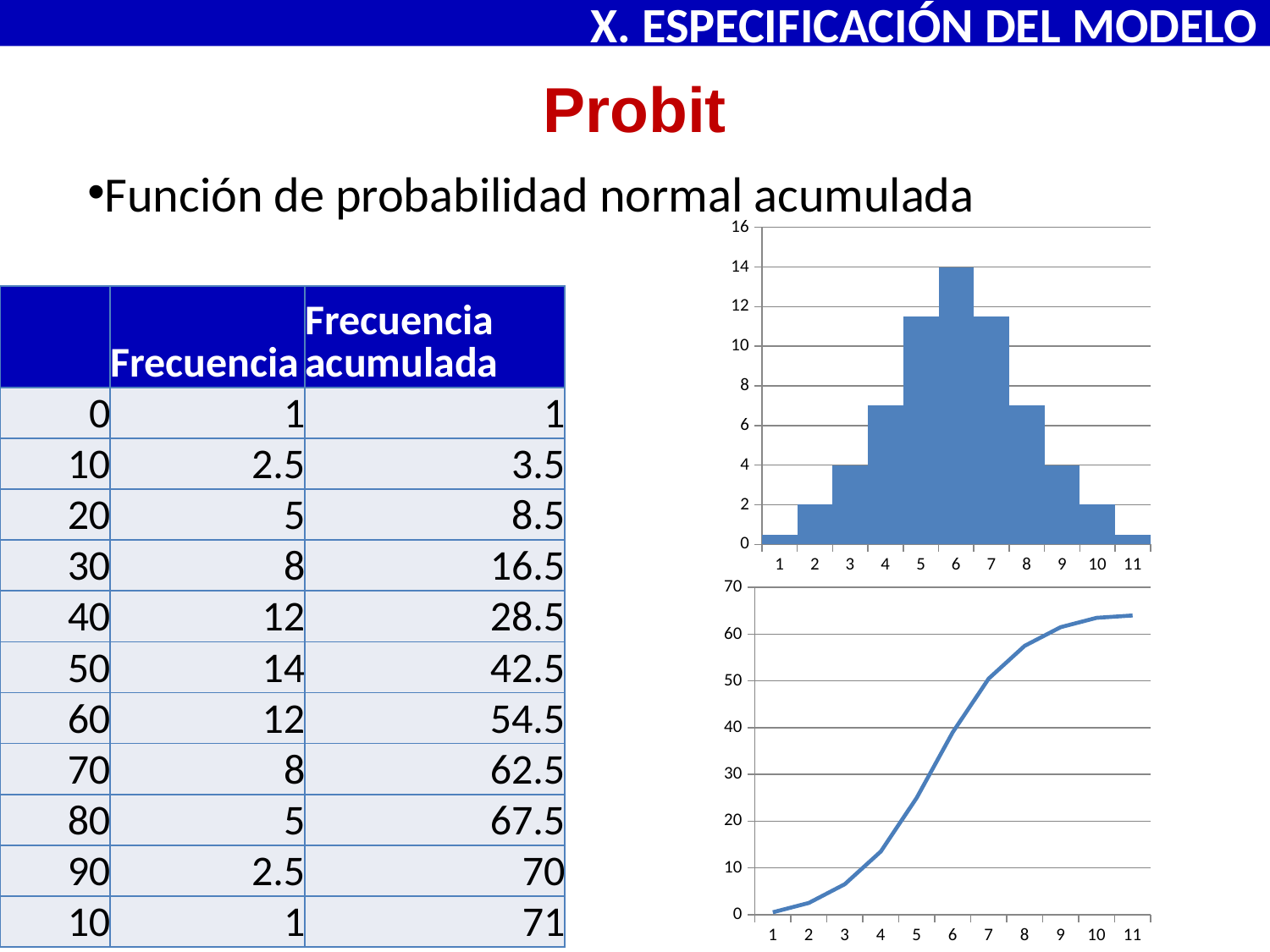
In the bottom line chart, is the value at point 1 greater or less than 10? less In the top bar chart, is the value for category 5 greater or less than 10? greater In the top bar chart, which is larger, the bar for category 6 or the bar for category 3? category 6 In the top bar chart, which category has the highest bar? 6 In the top bar chart, is the value for category 6 greater or less than 12? greater In the bottom line chart, how many points are plotted along the x axis? 11 In the top bar chart, how many categories are shown on the x axis? 11 What kind of chart is the bottom chart on the right of the slide? line chart What kind of chart is the top chart on the right of the slide? bar chart In the bottom line chart, do the values rise or fall as you move from left to right along the x axis? rise